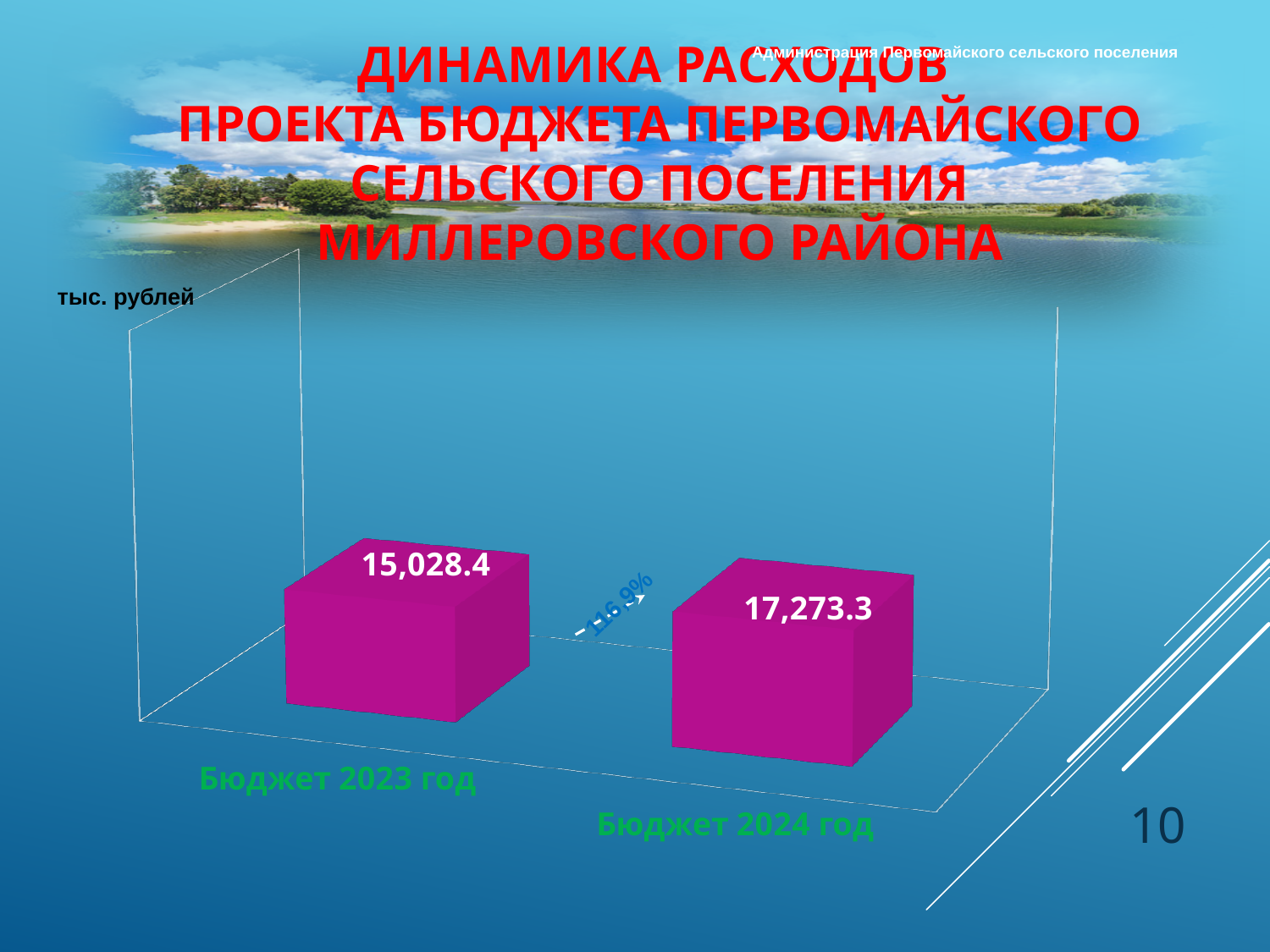
What colour are the bars on the chart? magenta (purple-pink) What is the difference between the values for Бюджет 2024 год and Бюджет 2023 год? 2,244.9 What percentage is printed between the two bars? 116.9% What is the value shown for Бюджет 2023 год? 15,028.4 What is the value shown for Бюджет 2024 год? 17,273.3 Is the value for Бюджет 2023 год larger or smaller than the value for Бюджет 2024 год? smaller Do the values rise or fall from Бюджет 2023 год to Бюджет 2024 год? rise What type of chart is shown on the slide? bar chart Which category has the lowest value on the chart? Бюджет 2023 год Which category has the higher value, Бюджет 2023 год or Бюджет 2024 год? Бюджет 2024 год What unit of measurement is indicated in the top-left corner of the chart? тыс. рублей How many bars are plotted on the chart? 2